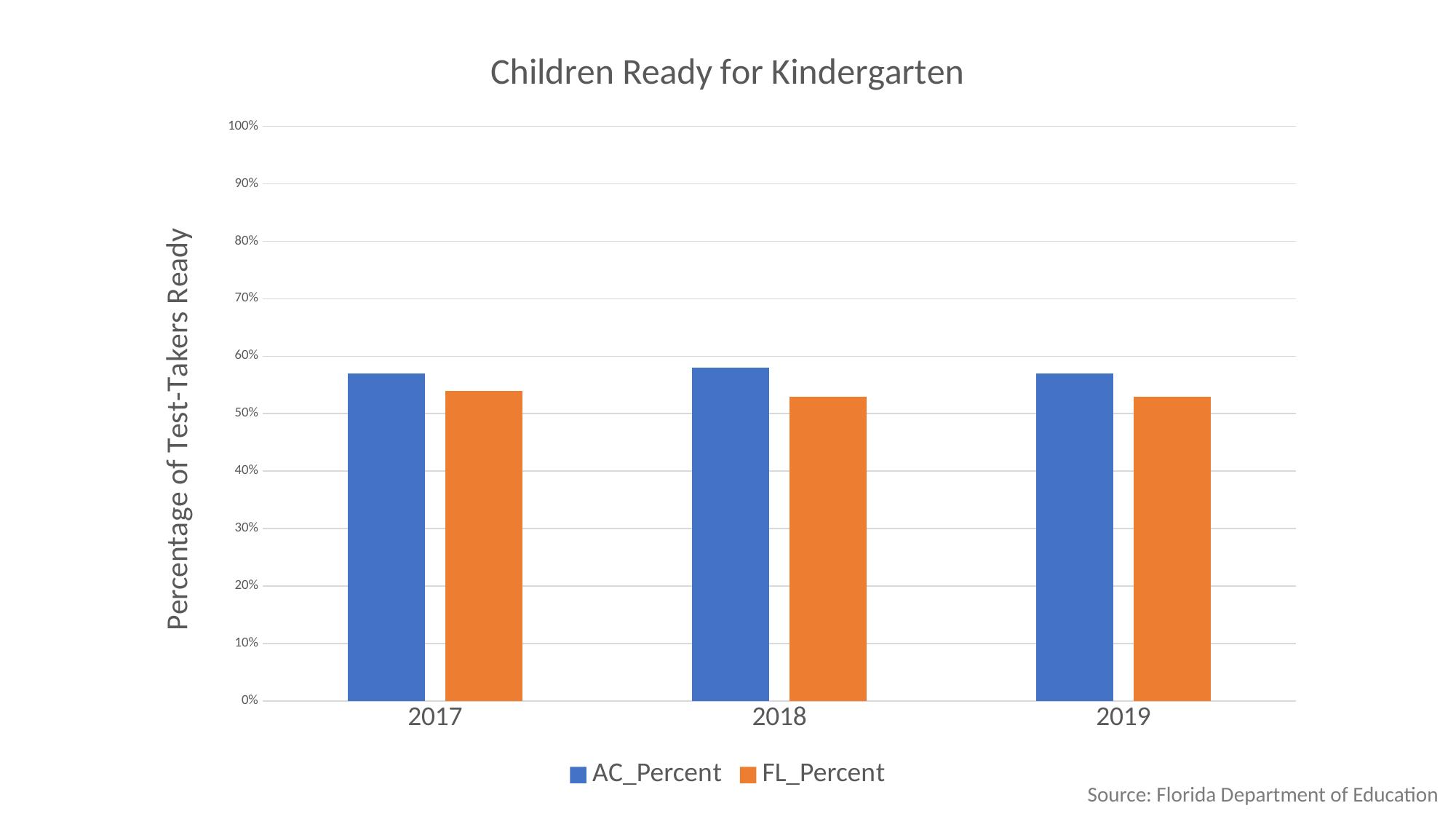
How many series does the legend list? 2 Which series is shown in orange in the chart? FL_Percent In 2017, which series has the smaller value, AC_Percent or FL_Percent? FL_Percent In 2019, which series has the larger value, AC_Percent or FL_Percent? AC_Percent Is the value for FL_Percent in 2019 greater or less than 60%? less What is the title of the chart? Children Ready for Kindergarten Is the value for AC_Percent in 2018 greater or less than 50%? greater What kind of chart is shown on the slide? bar chart How many years are shown on the x axis of the chart? 3 Is the value for FL_Percent in 2017 greater or less than 50%? greater In 2018, which series has the larger value, AC_Percent or FL_Percent? AC_Percent